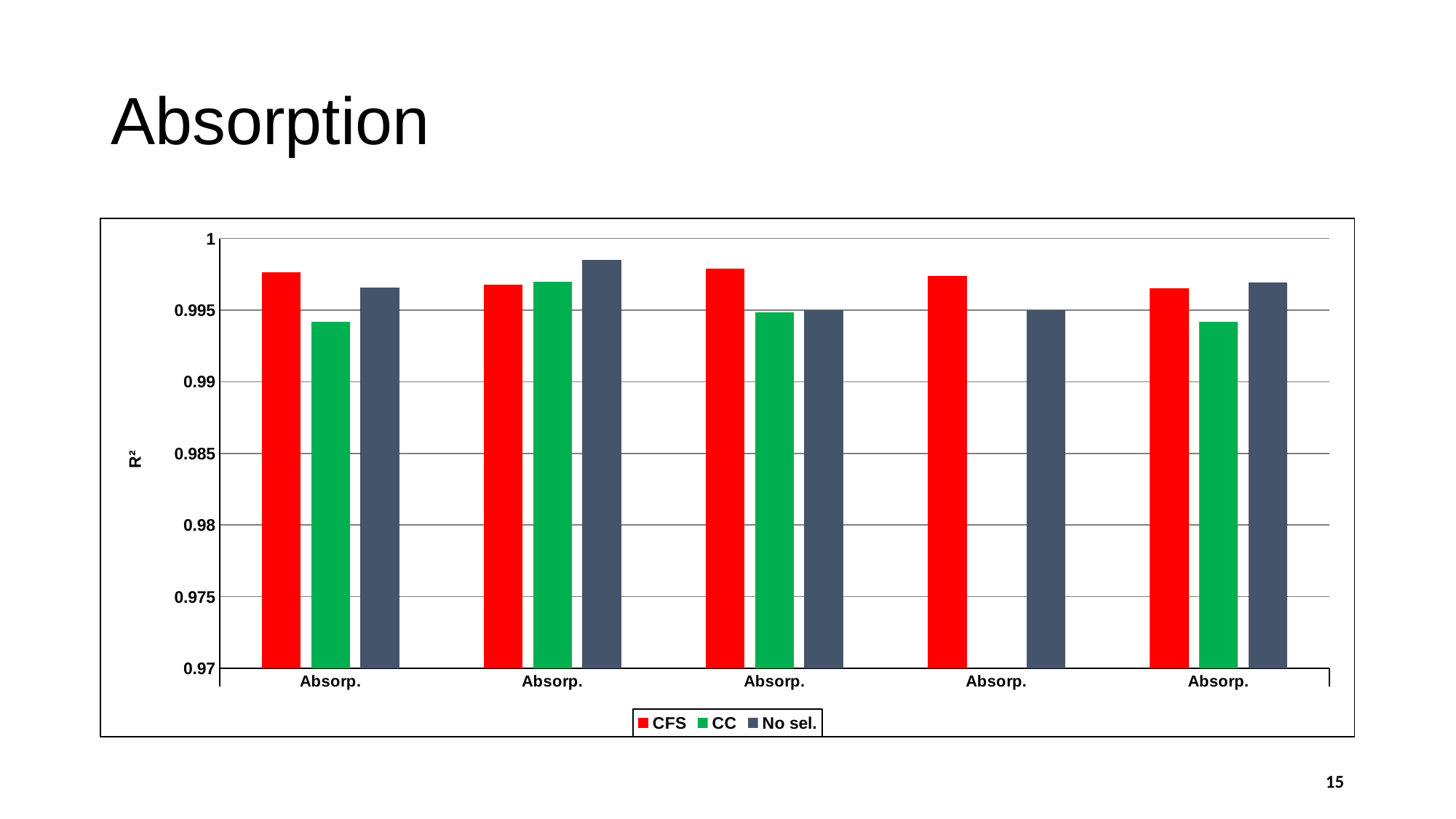
How many groups of bars are plotted along the x axis? 5 In the first group from the left, is the CFS value greater or less than 0.995? greater In the second group from the left, which is larger, the No sel. bar or the CFS bar? No sel. How many series does the legend list? 3 Which series is missing from the fourth group from the left? CC What kind of chart is shown on the slide? bar chart In the fifth group from the left, is the CC value greater or less than 0.99? greater How many bars are plotted in the fourth group from the left? 2 What is the label on the vertical axis? R² In the second group from the left, is the No sel. value greater or less than 0.995? greater What are the series names listed in the legend? CFS, CC, No sel. In the first group from the left, which is larger, the CFS bar or the CC bar? CFS